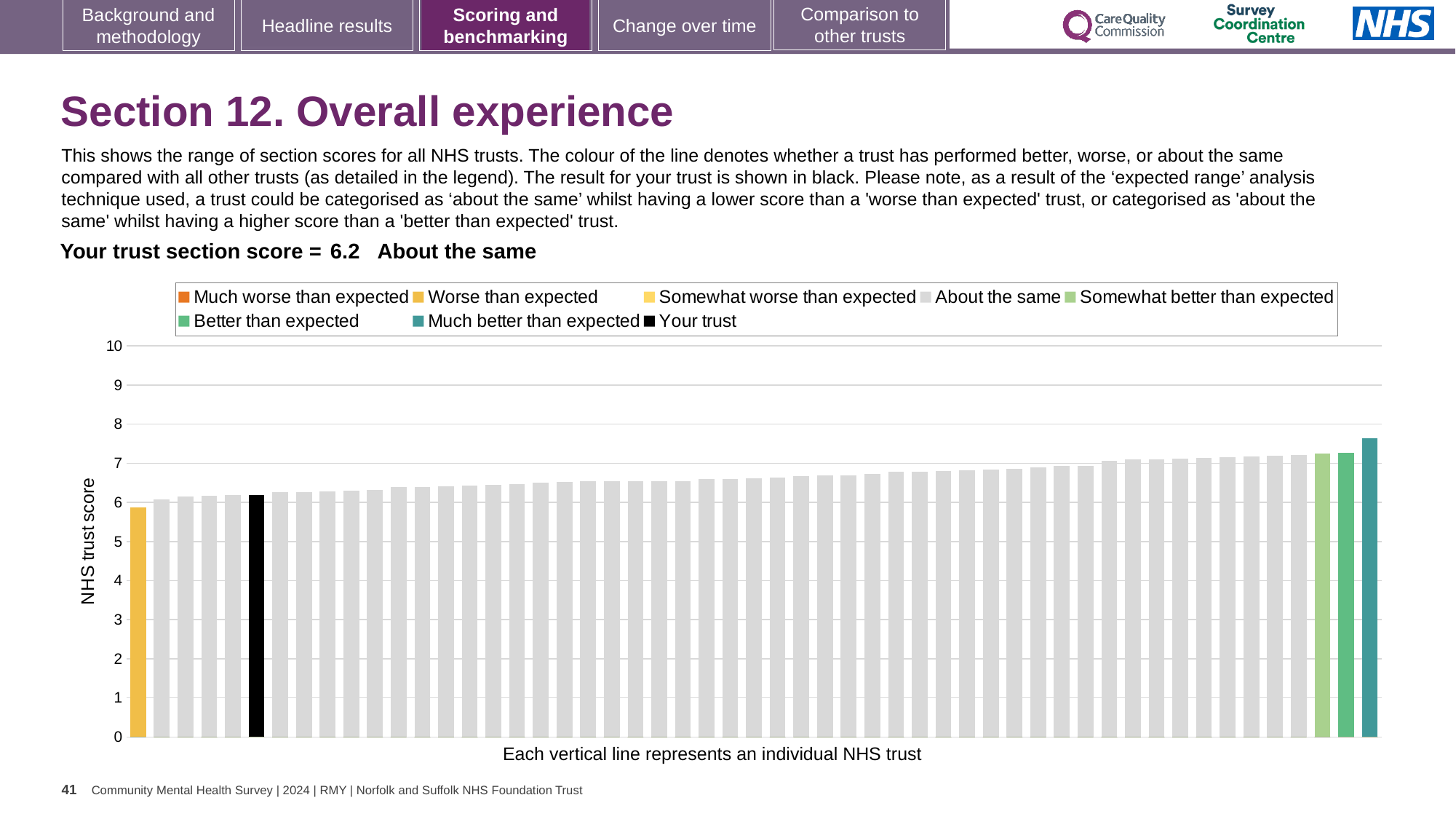
How many entries does the chart legend list? 8 What is the label on the vertical axis of the chart? NHS trust score Is the value of the tallest bar (Much better than expected) greater or less than 7? greater What kind of chart is shown on the slide? bar chart How is your trust's section score categorised compared with other trusts? About the same Is the value of the black 'Your trust' bar greater or less than 7? less What colour is used for the bar representing your trust? black Is the black 'Your trust' bar higher or lower than the teal 'Much better than expected' bar? lower How many bars are coloured as 'Much better than expected'? 1 What is the section score for your trust shown on the slide? 6.2 Do the bar values rise or fall from left to right across the chart? rise Is the value of the yellow 'Worse than expected' bar greater or less than 5? greater